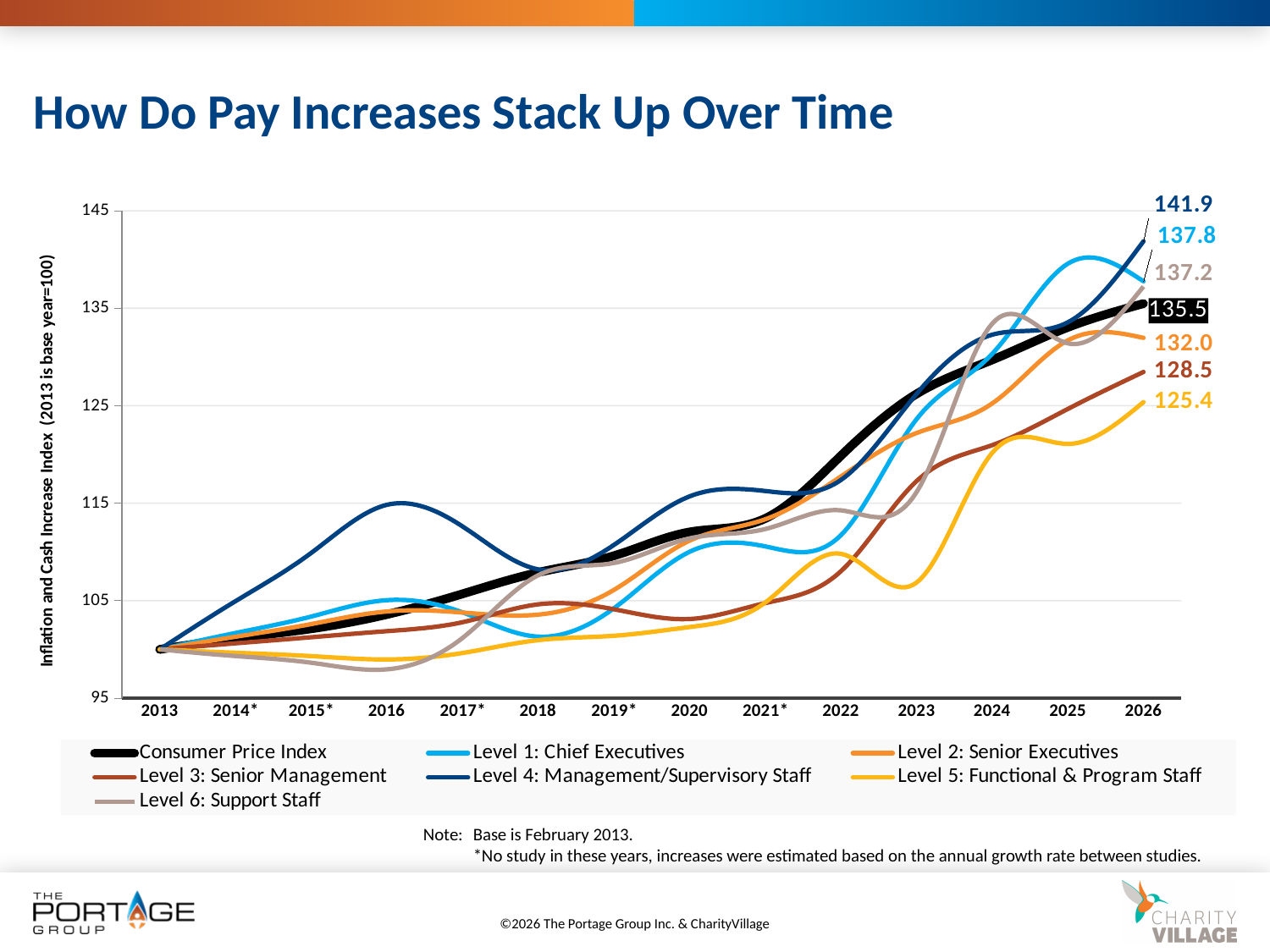
What is the 2026 value for Level 4: Management/Supervisory Staff? 141.9 How many series does the legend list? 7 In 2026, which is larger: Level 1: Chief Executives or Level 3: Senior Management? Level 1: Chief Executives What is the 2026 value for Level 5: Functional & Program Staff? 125.4 Which series has the highest value in 2026? Level 4: Management/Supervisory Staff What is the 2026 value for Level 2: Senior Executives? 132.0 Does the Consumer Price Index rise or fall from 2013 to 2026? Rise Is the value for Level 4: Management/Supervisory Staff in 2016 greater or less than 105? greater What is the 2026 value for the Consumer Price Index? 135.5 What is the difference between the 2026 values for Level 4: Management/Supervisory Staff and Level 5: Functional & Program Staff? 16.5 What kind of chart is shown on the slide? Line chart Which series has the lowest value in 2026? Level 5: Functional & Program Staff